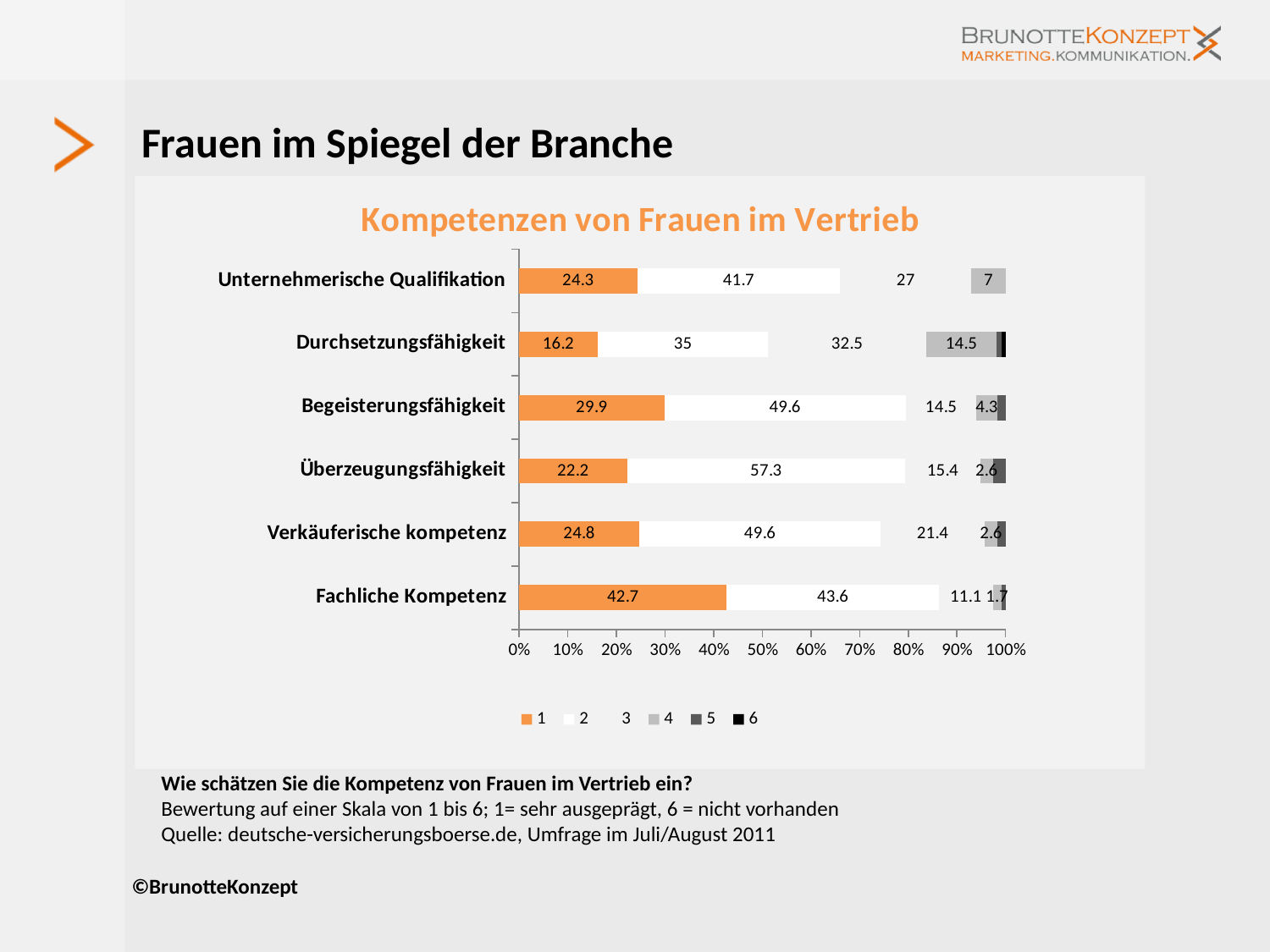
How many categories are shown on the chart? 6 How many series does the legend list? 6 What is the value of series 1 for Fachliche Kompetenz? 42.7 Which is larger: the series 3 value for Verkäuferische kompetenz or for Begeisterungsfähigkeit? Verkäuferische kompetenz What is the difference between the series 2 values for Überzeugungsfähigkeit and Durchsetzungsfähigkeit? 22.3 What kind of chart is shown on the slide? stacked bar chart What is the value of series 4 for Unternehmerische Qualifikation? 7 What is the value of series 3 for Durchsetzungsfähigkeit? 32.5 What is the title of the chart? Kompetenzen von Frauen im Vertrieb Which category has the highest value for series 1? Fachliche Kompetenz Which category has the lowest value for series 1? Durchsetzungsfähigkeit What is the value of series 2 for Überzeugungsfähigkeit? 57.3